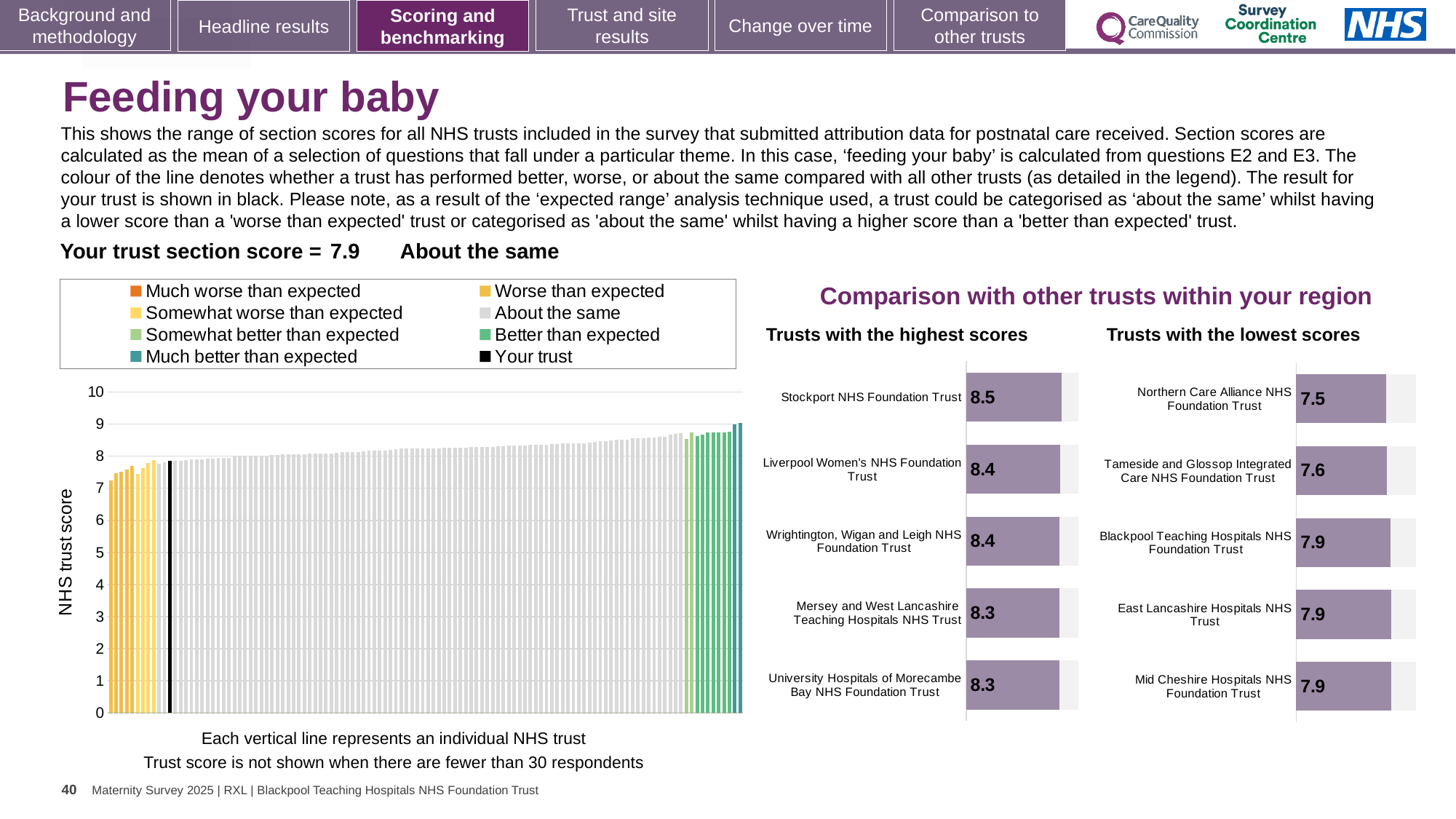
In the 'Trusts with the highest scores' chart, what is the difference between the scores of Stockport NHS Foundation Trust and University Hospitals of Morecambe Bay NHS Foundation Trust? 0.2 In the 'Trusts with the lowest scores' chart, which trust has the lowest score? Northern Care Alliance NHS Foundation Trust How many entries does the legend above the 'NHS trust score' chart list? 8 In the 'Trusts with the highest scores' chart, what is the score for Stockport NHS Foundation Trust? 8.5 What kind of chart is the 'NHS trust score' chart on the left of the slide? Bar chart In the 'Trusts with the lowest scores' chart, which has the larger score: Blackpool Teaching Hospitals NHS Foundation Trust or Northern Care Alliance NHS Foundation Trust? Blackpool Teaching Hospitals NHS Foundation Trust In the 'NHS trust score' chart on the left, do the bar heights rise or fall from left to right? Rise How many trusts are listed in the 'Trusts with the highest scores' chart? 5 In the 'Trusts with the highest scores' chart, which trust has the highest score? Stockport NHS Foundation Trust In the 'Trusts with the lowest scores' chart, what is the score for Northern Care Alliance NHS Foundation Trust? 7.5 In the 'Trusts with the lowest scores' chart, what is the score for Tameside and Glossop Integrated Care NHS Foundation Trust? 7.6 In the 'NHS trust score' chart on the left, is the value of the rightmost bar greater or less than 8? greater